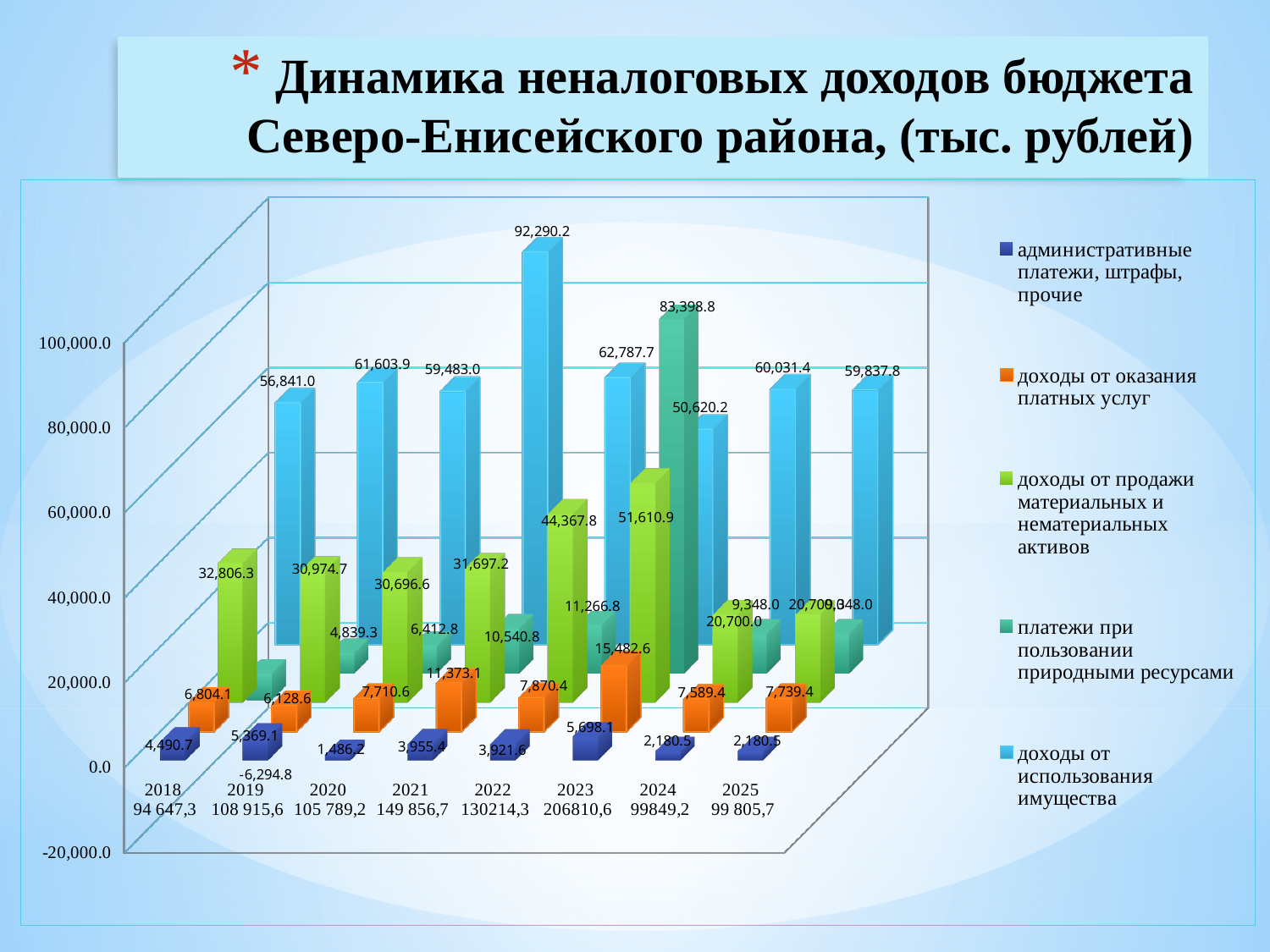
What is the value of 'доходы от использования имущества' for 2018? 56,841.0 Which is larger: 'доходы от продажи материальных и нематериальных активов' in 2022 or in 2021? 2022 In which year is 'доходы от использования имущества' highest? 2021 What kind of chart is shown on the slide? bar chart How many series does the legend list? 5 What is the value of 'доходы от использования имущества' for 2021? 92,290.2 What is the difference between 'доходы от использования имущества' in 2021 and in 2022? 29,502.5 In which year is 'доходы от использования имущества' lowest? 2023 What is the value of 'платежи при пользовании природными ресурсами' for 2023? 83,398.8 Does 'доходы от использования имущества' rise or fall from 2018 to 2021? rise What is the value of 'доходы от оказания платных услуг' for 2023? 15,482.6 How many years are shown along the x axis? 8